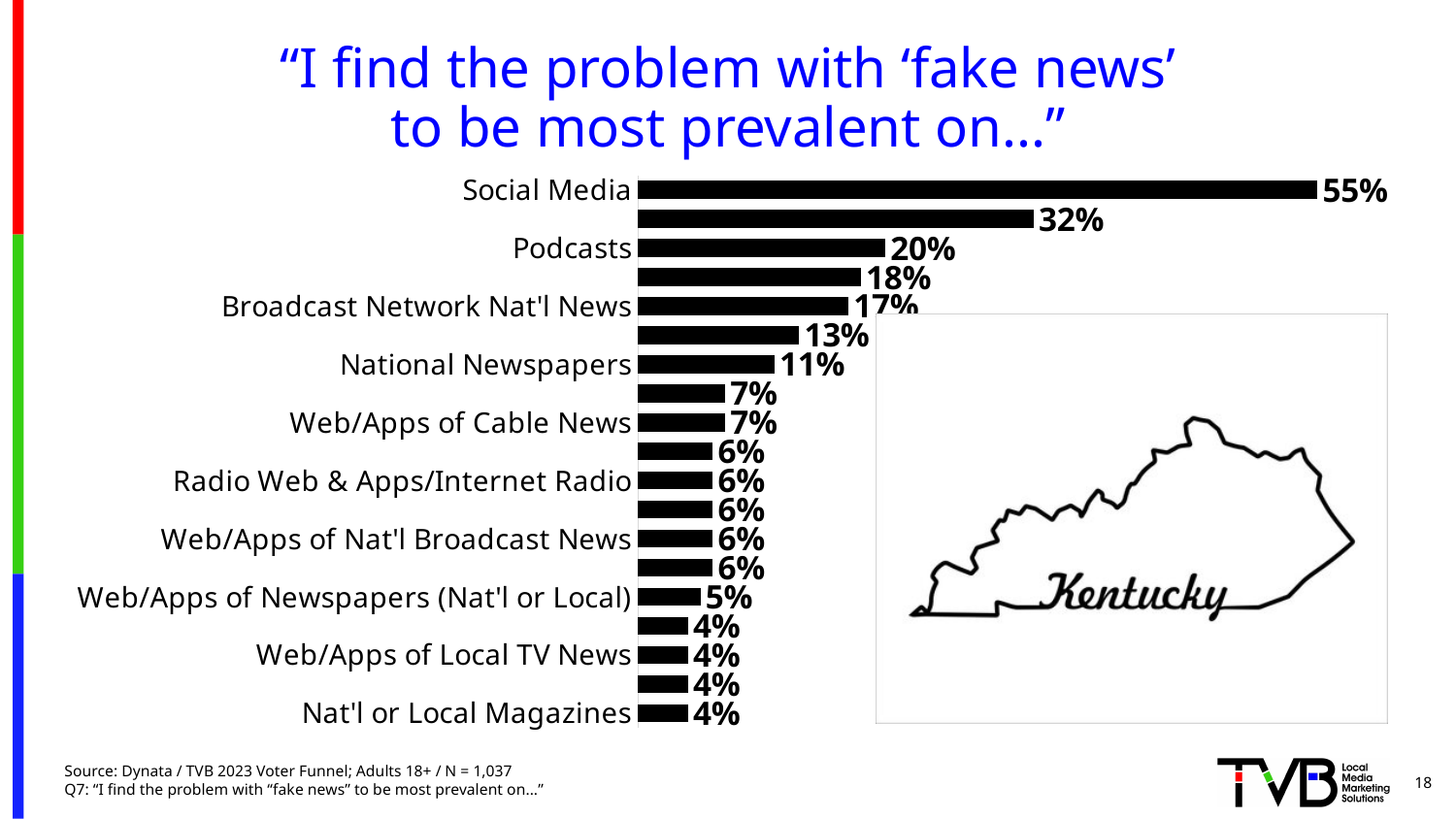
What is the difference between the values for Broadcast Network Nat'l News and National Newspapers? 6% What is the value shown for Web/Apps of Newspapers (Nat'l or Local)? 5% What is the value shown for Podcasts? 20% What percentage of respondents said the problem with 'fake news' is most prevalent on Social Media? 55% Which is larger, the value for Podcasts or the value for Web/Apps of Cable News? Podcasts What kind of chart is shown on the slide? Bar chart What is the value shown for Nat'l or Local Magazines? 4% Which category has the highest value on the chart? Social Media What is the value shown for National Newspapers? 11% What is the value shown for Broadcast Network Nat'l News? 17% What is the difference between the values for Social Media and Podcasts? 35% Which U.S. state is outlined in the image next to the chart? Kentucky